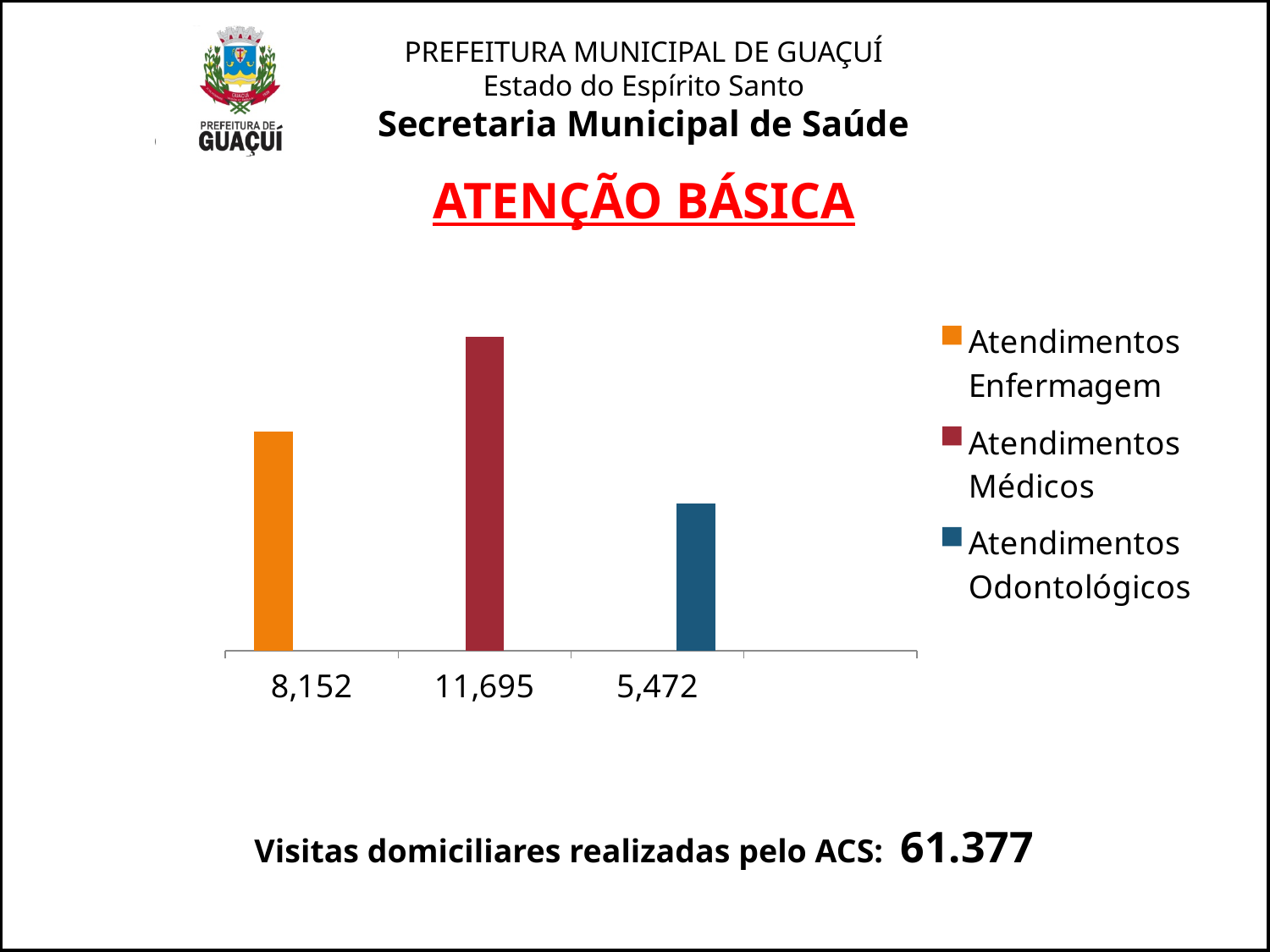
What is the difference between Atendimentos Médicos and Atendimentos Enfermagem? 3,543 What kind of chart is shown on the slide? Bar chart How many series does the legend list? 3 What is the value for Atendimentos Odontológicos? 5,472 What is the value for Atendimentos Enfermagem? 8,152 How many bars are plotted in the chart? 3 Which series has the lowest value? Atendimentos Odontológicos What is the value for Atendimentos Médicos? 11,695 Which series has the highest value? Atendimentos Médicos Which is larger, Atendimentos Enfermagem or Atendimentos Odontológicos? Atendimentos Enfermagem What is the difference between Atendimentos Enfermagem and Atendimentos Odontológicos? 2,680 What colour is the bar for Atendimentos Médicos? Red